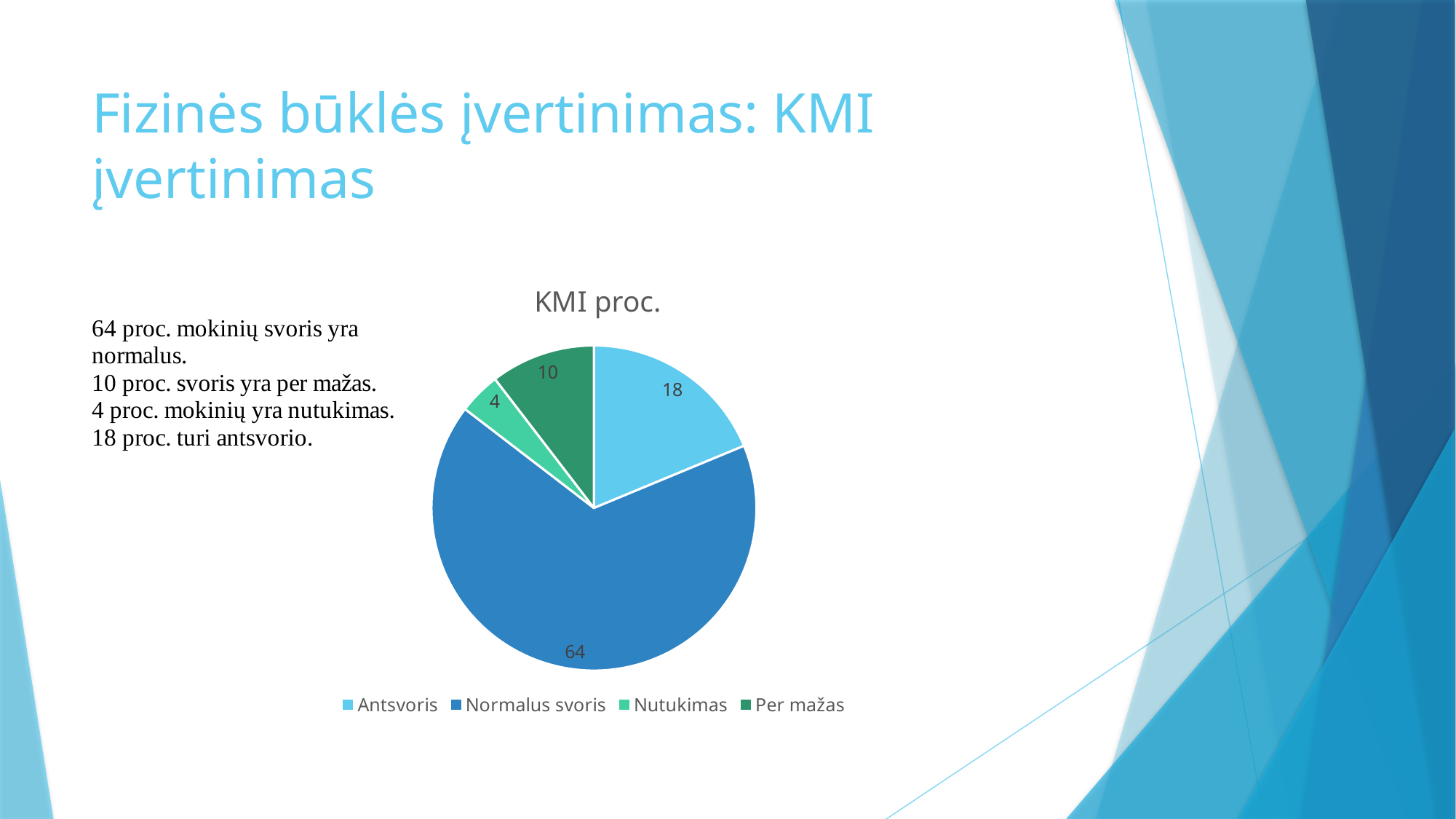
What type of chart is shown on the slide? Pie chart Which category has the smallest slice in the pie chart? Nutukimas What is the value for Per mažas in the pie chart? 10 Which is larger, the value for Per mažas or the value for Nutukimas? Per mažas Which category has the largest slice in the pie chart? Normalus svoris What is the total of all the slice values in the pie chart? 96 How many slices does the pie chart have? 4 What is the value for Antsvoris in the pie chart? 18 What is the difference between the values for Normalus svoris and Antsvoris? 46 What is the value for Nutukimas in the pie chart? 4 What is the title of the chart? KMI proc. What is the value for Normalus svoris in the pie chart? 64